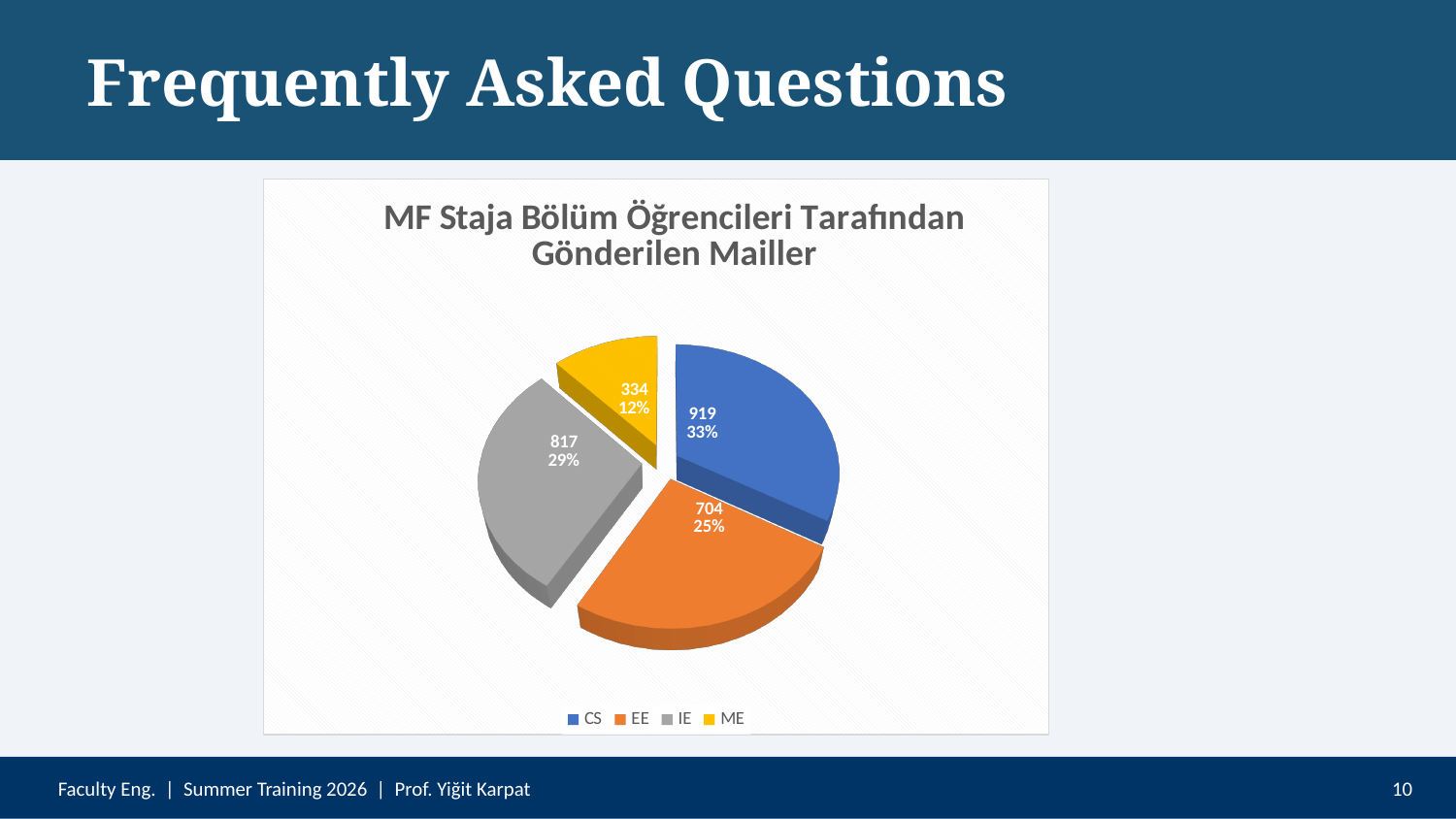
What share of the pie does IE represent? 29% What is the value for IE? 817 What is the value for CS? 919 Which category has the largest slice? CS What is the value for EE? 704 What is the value for ME? 334 What is the difference between the values for CS and EE? 215 Which is larger, the value for IE or the value for EE? IE Which category has the smallest slice? ME What share of the pie does ME represent? 12% What kind of chart is shown on the slide? pie chart How many categories does the legend list? 4